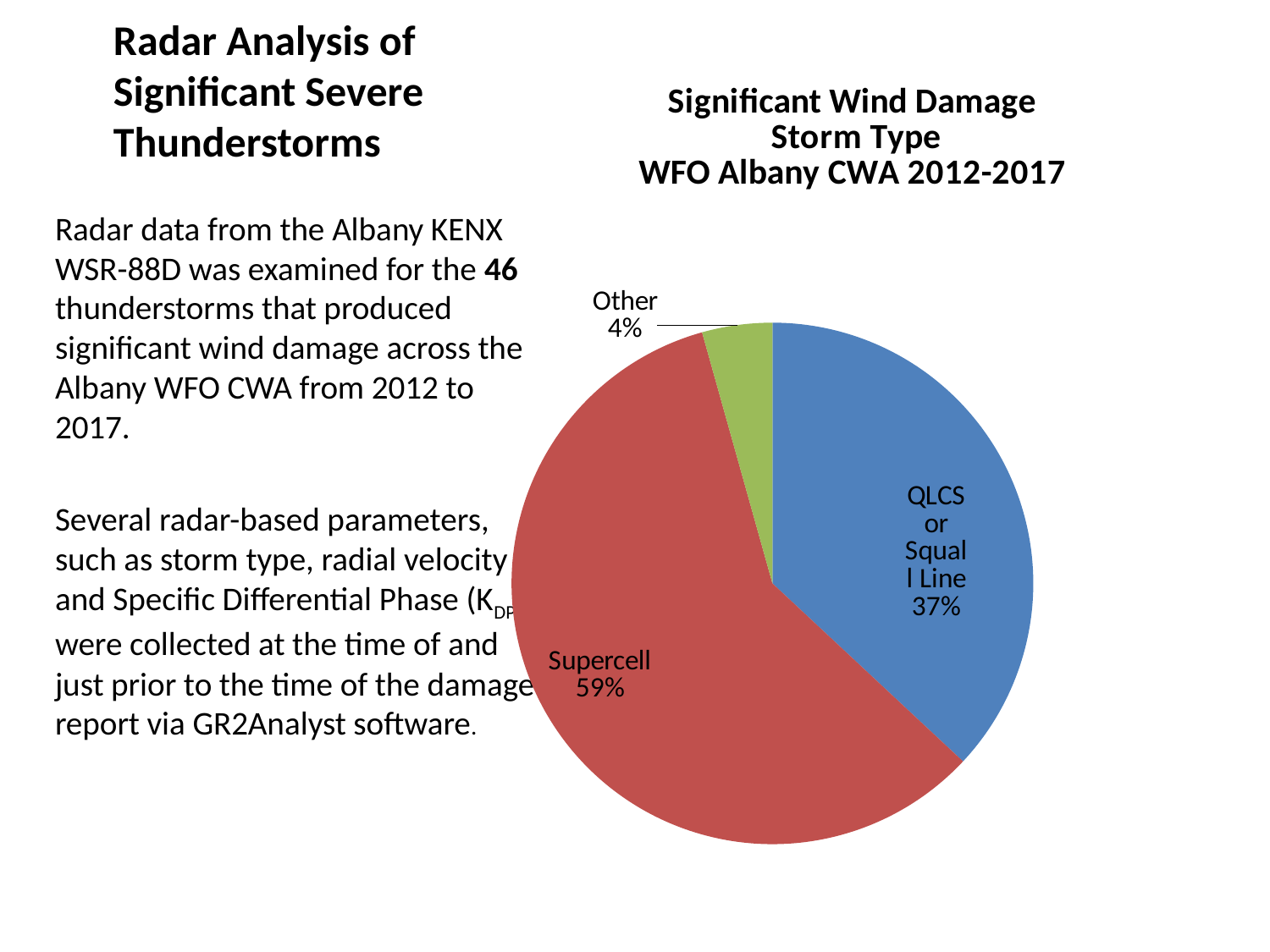
What type of chart is shown on the slide? pie chart How many slices does the pie chart have? 3 What colour is the Supercell slice? red Which storm type has the largest share of the pie? Supercell What is the difference in percentage points between the QLCS or Squall Line and Other shares? 33 What share of the pie does Other represent? 4% Which storm type has the smallest share of the pie? Other What share of the pie does QLCS or Squall Line represent? 37% What is the title of the chart? Significant Wind Damage Storm Type WFO Albany CWA 2012-2017 Which is larger, the share for QLCS or Squall Line or the share for Other? QLCS or Squall Line What is the difference in percentage points between the Supercell and QLCS or Squall Line shares? 22 What share of the pie does Supercell represent? 59%